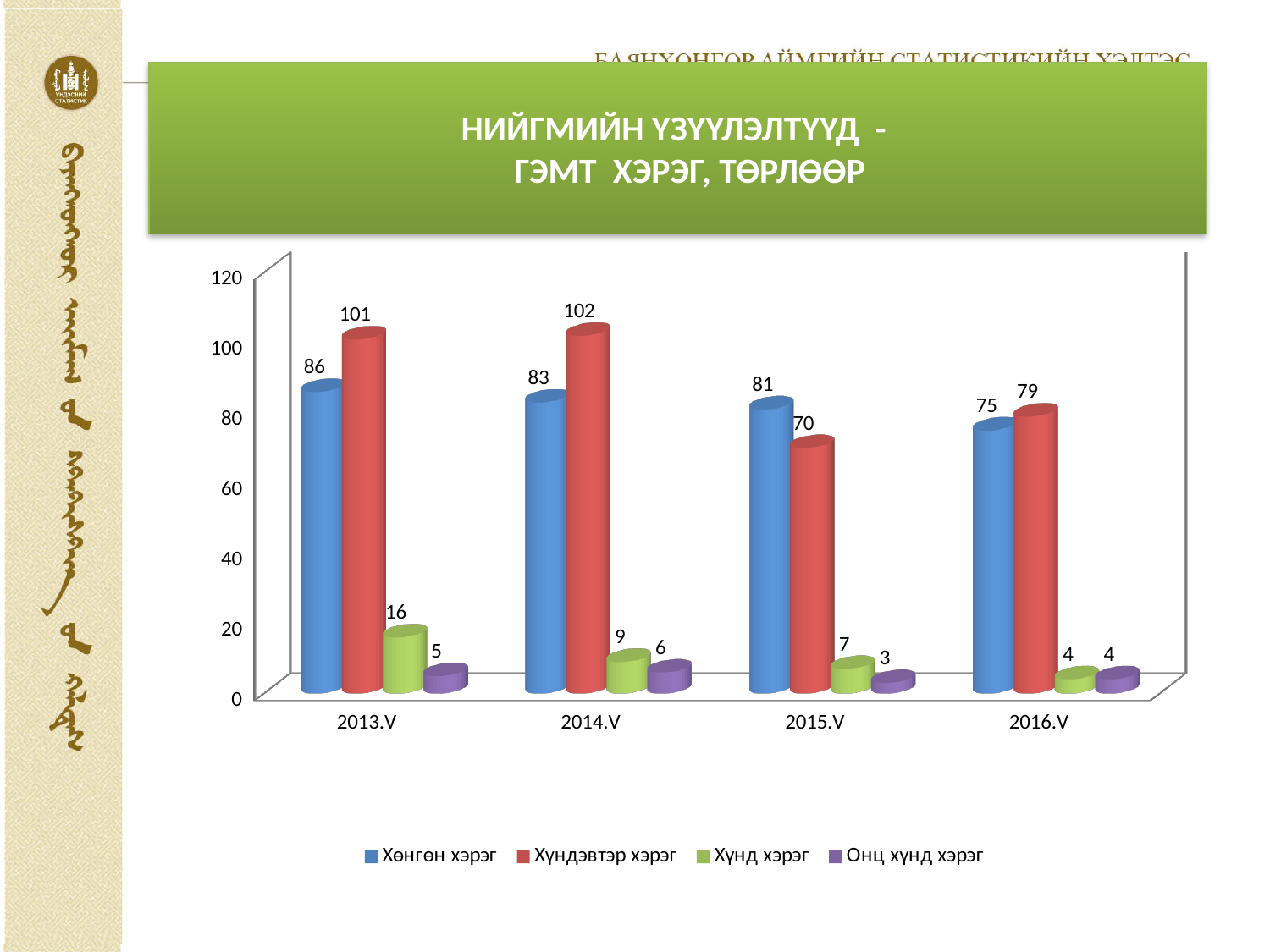
In which year is the value for Хөнгөн хэрэг lowest? 2016.V What kind of chart is shown on the slide? Bar chart In which year is the value for Хүндэвтэр хэрэг highest? 2014.V What is the value for Онц хүнд хэрэг in 2016.V? 4 What is the value for Хөнгөн хэрэг in 2013.V? 86 What is the value for Хүндэвтэр хэрэг in 2014.V? 102 What is the value for Хүнд хэрэг in 2015.V? 7 Does the value for Хөнгөн хэрэг rise or fall from 2013.V to 2016.V? Fall What is the difference between Хүндэвтэр хэрэг and Хөнгөн хэрэг in 2013.V? 15 How many years are shown on the x axis? 4 Which is larger in 2015.V, Хөнгөн хэрэг or Хүндэвтэр хэрэг? Хөнгөн хэрэг How many series does the legend list? 4